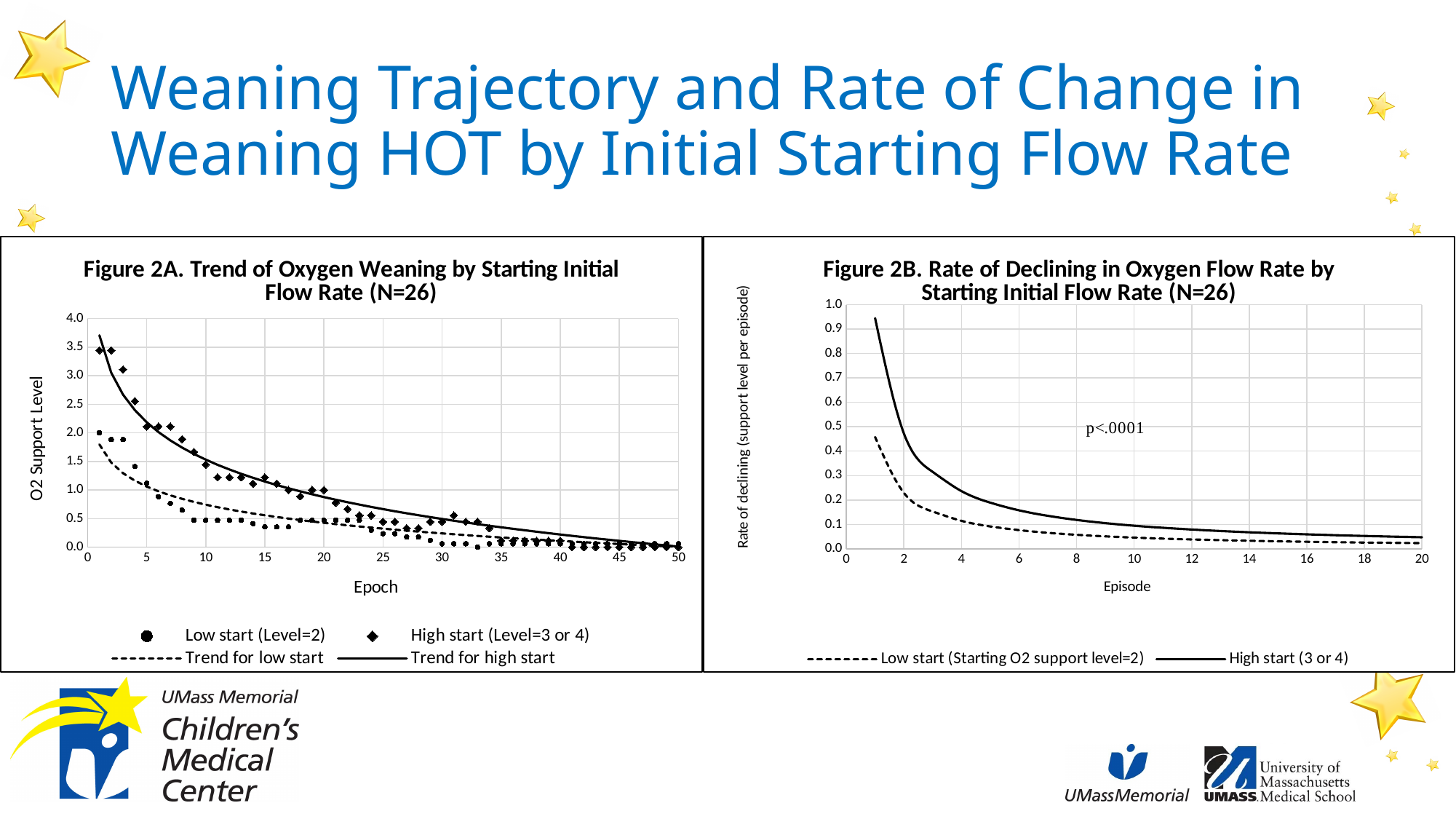
In Figure 2B, is the High start value at episode 1 greater or less than 0.8? greater In Figure 2A, is the High start value at epoch 1 greater or less than 3.0? greater In Figure 2B, at episode 4, which series has the higher rate of declining, Low start or High start? High start In Figure 2A, at epoch 1, which series has the higher O2 support level, Low start or High start? High start In Figure 2B, is the Low start value at episode 1 greater or less than 0.5? less In Figure 2A, do the O2 support levels rise or fall as the epoch increases? Fall How many series does the legend of Figure 2B list? 2 What kind of chart is Figure 2A? Scatter chart with trend lines How many entries does the legend of Figure 2A list? 4 What p-value is printed on Figure 2B? p<.0001 What kind of chart is Figure 2B? Line chart In Figure 2B, does the rate of declining rise or fall as the episode number increases? Fall